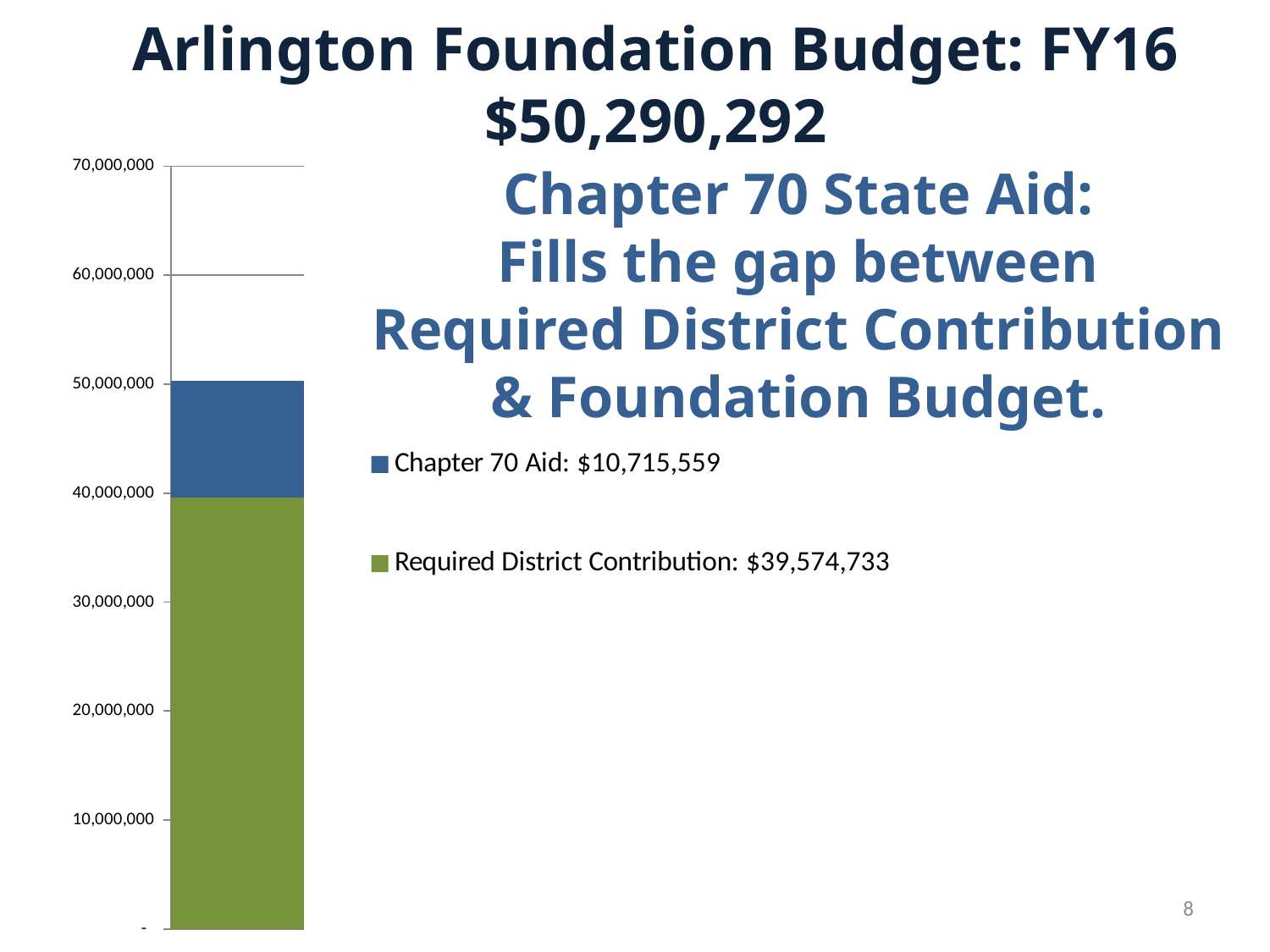
Which colour represents Chapter 70 Aid in the chart? blue How many bars are plotted in the chart? 1 Which series has the larger value, Chapter 70 Aid or Required District Contribution? Required District Contribution What is the value for Chapter 70 Aid? $10,715,559 What is the value for Required District Contribution? $39,574,733 What is the total of the stacked bar? $50,290,292 How many series does the legend list? 2 What is the difference between Required District Contribution and Chapter 70 Aid? $28,859,174 What kind of chart is shown on the slide? stacked bar chart Is the total height of the stacked bar greater or less than 60,000,000? less Which series has the smallest value? Chapter 70 Aid Is the value for Required District Contribution greater or less than 30,000,000? greater